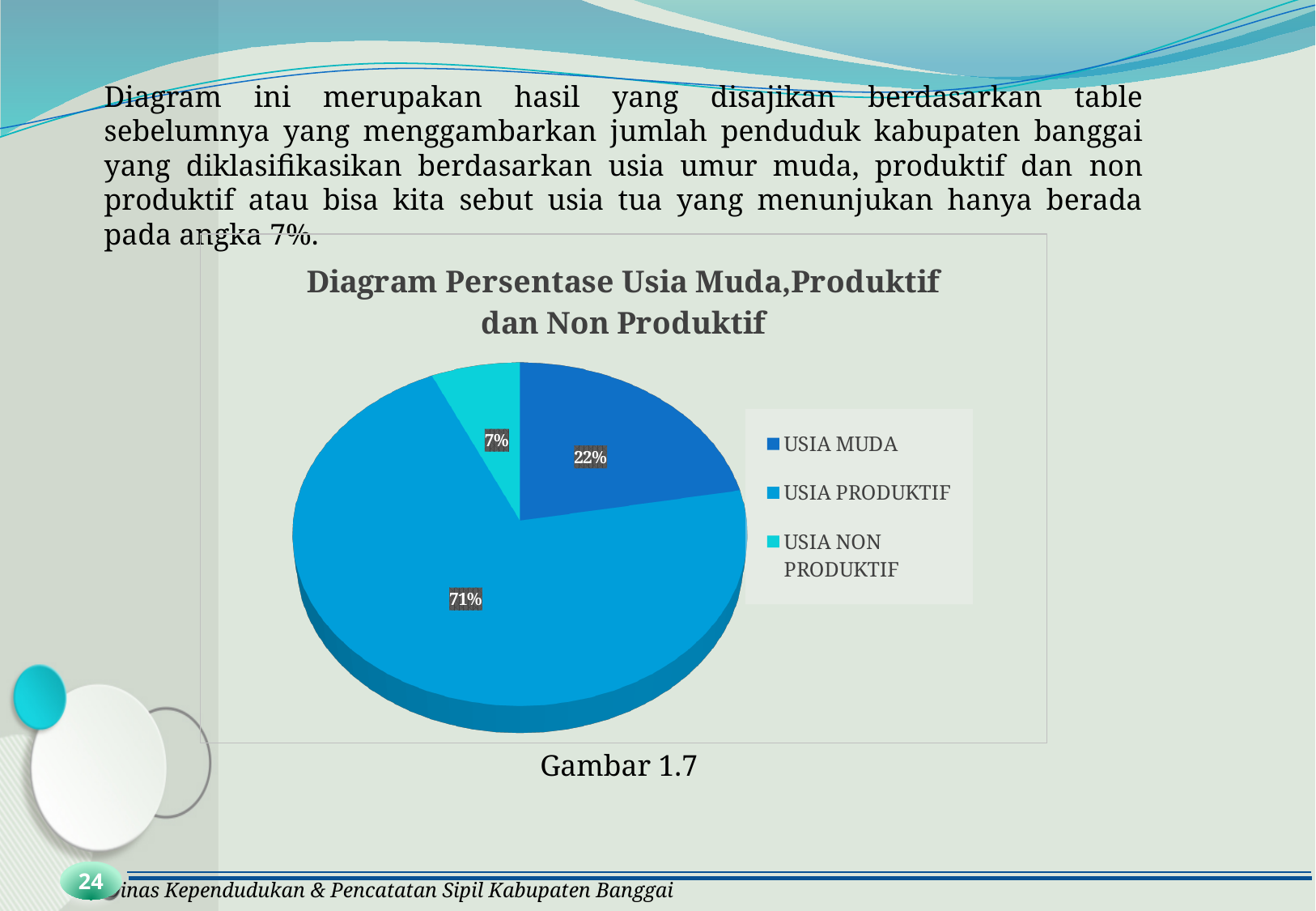
What is the title of the chart? Diagram Persentase Usia Muda,Produktif dan Non Produktif What percentage of the pie is USIA MUDA? 22% Which category has the largest share of the pie? USIA PRODUKTIF Which is larger, the share for USIA MUDA or the share for USIA NON PRODUKTIF? USIA MUDA How many entries does the legend list? 3 What percentage of the pie is USIA NON PRODUKTIF? 7% What kind of chart is shown on the slide? Pie chart What is the difference in percentage points between USIA PRODUKTIF and USIA MUDA? 49 What percentage of the pie is USIA PRODUKTIF? 71% Which category has the smallest share of the pie? USIA NON PRODUKTIF What is the difference in percentage points between USIA MUDA and USIA NON PRODUKTIF? 15 How many slices does the pie chart have? 3